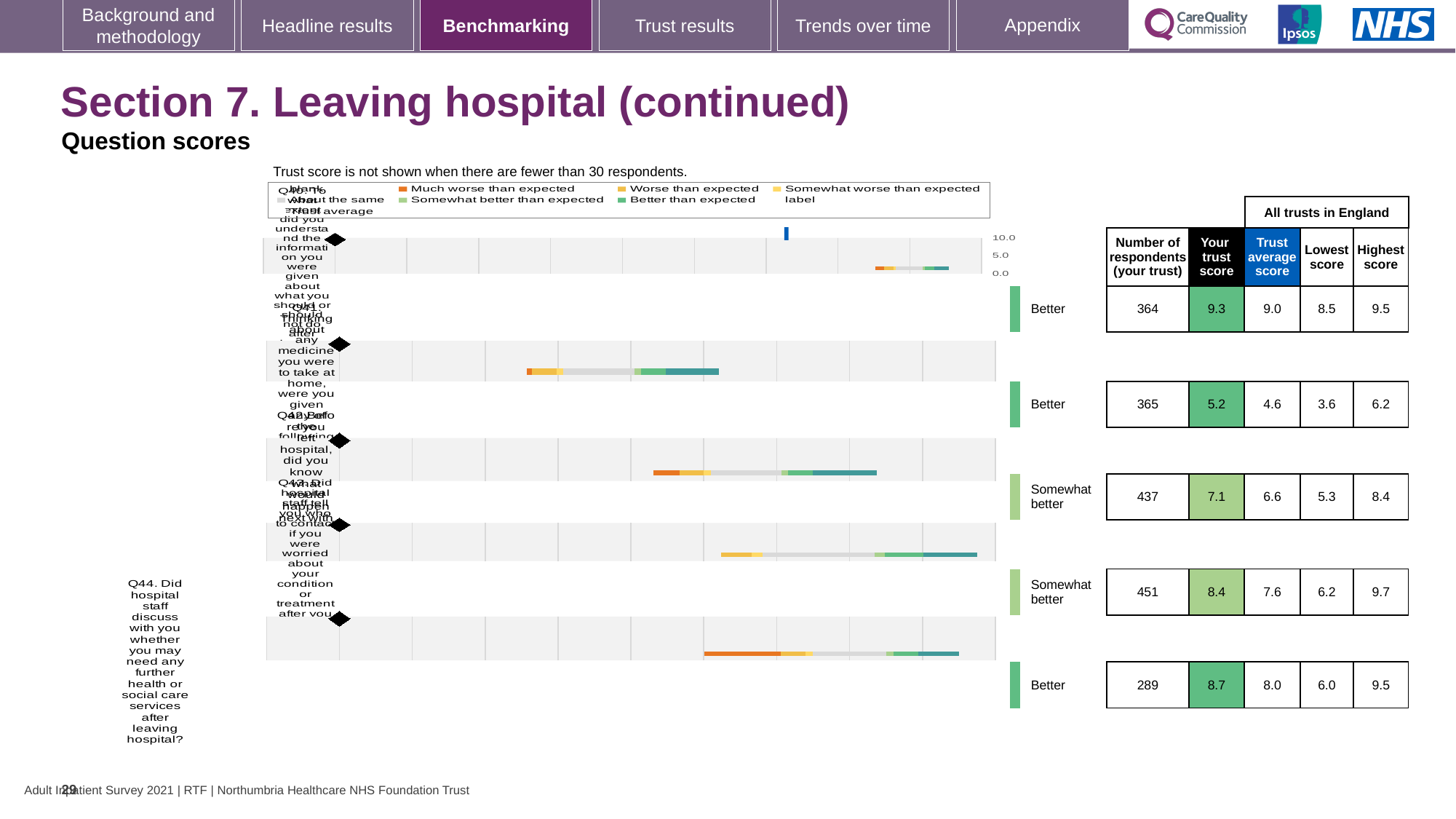
What is the 'Your trust score' for the first question row in the table? 9.3 What kind of chart is used to show the question scores? Bar chart What is the difference between the trust score and the trust average score for Q44 (the last row)? 0.7 How many question rows are rated 'Better'? 3 What is the trust average score for Q44 (the last row)? 8.0 What is the lowest score across all trusts in England for Q44 (the last row)? 6.0 How many respondents are shown for the first question row in the table? 364 What is the 'Your trust score' for Q44 (the last row)? 8.7 What is the highest score across all trusts in England for Q44 (the last row)? 9.5 In the table, what is the number of respondents for Q44 (the last row)? 289 How many question rows are shown in the chart and table? 5 Which question row has the highest number of respondents, and what is that number? The fourth row, 451